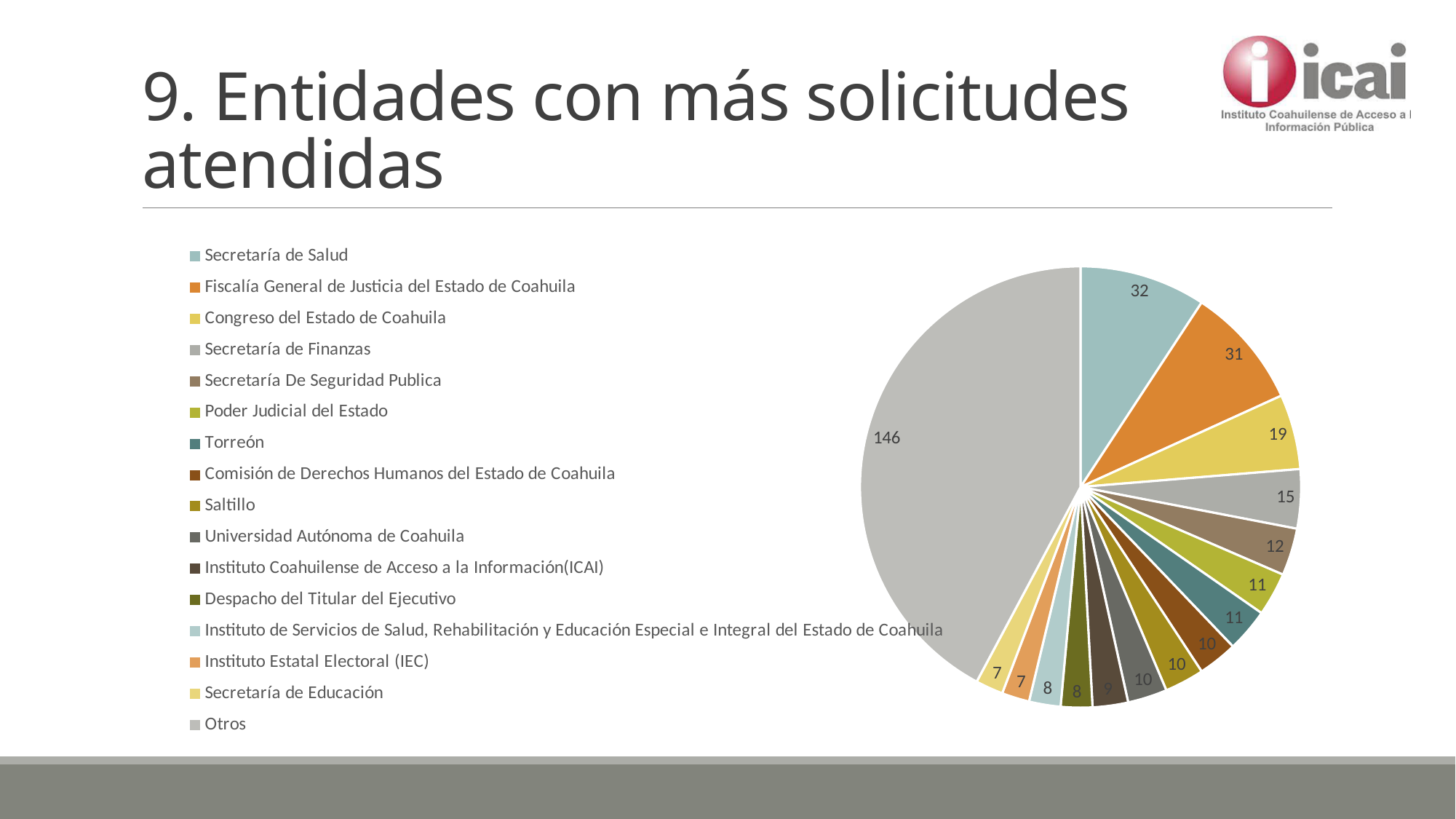
What type of chart is shown on the slide? Pie chart Which is larger, the value for Secretaría de Finanzas or the value for Secretaría De Seguridad Publica? Secretaría de Finanzas Which category has the largest slice of the pie? Otros What is the value for Secretaría de Finanzas? 15 What is the value for Otros? 146 What is the difference between the values for Otros and Secretaría de Salud? 114 How many slices does the pie chart have? 16 What is the title of the slide containing the chart? 9. Entidades con más solicitudes atendidas What is the value for Congreso del Estado de Coahuila? 19 What is the value for Secretaría de Salud? 32 What is the value for Fiscalía General de Justicia del Estado de Coahuila? 31 What is the difference between the values for Secretaría de Salud and Congreso del Estado de Coahuila? 13